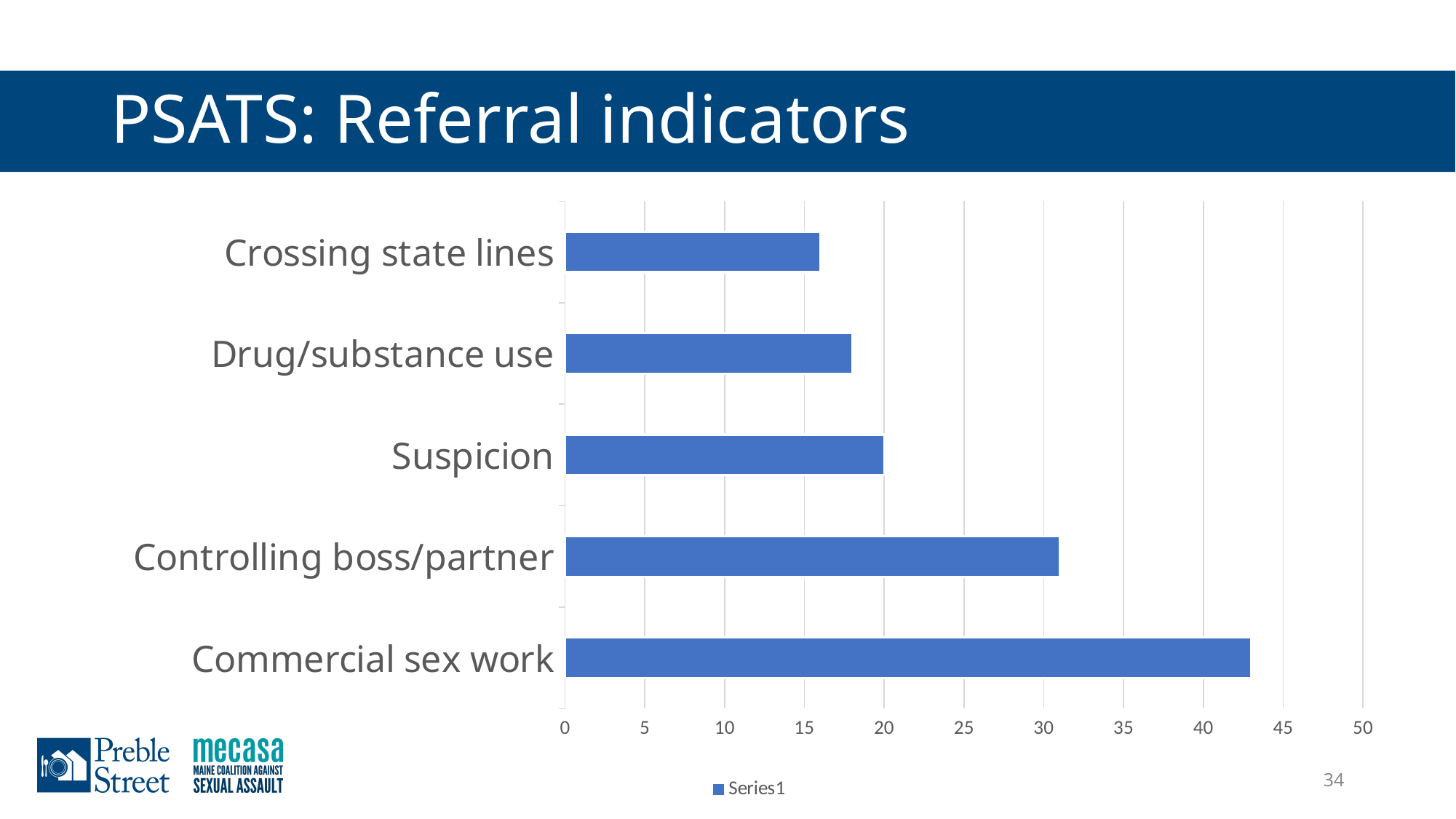
Is the value for Commercial sex work greater or less than 40? greater Is the value for Drug/substance use greater or less than 20? less Which category has the highest value? Commercial sex work Which category has the lowest value? Crossing state lines How many series does the legend list? 1 Which is larger, the value for Commercial sex work or the value for Drug/substance use? Commercial sex work Which is larger, the value for Controlling boss/partner or the value for Suspicion? Controlling boss/partner Is the value for Controlling boss/partner greater or less than 25? greater What is the title of the slide containing the chart? PSATS: Referral indicators How many categories are plotted in the chart? 5 What kind of chart is shown on the slide? bar chart